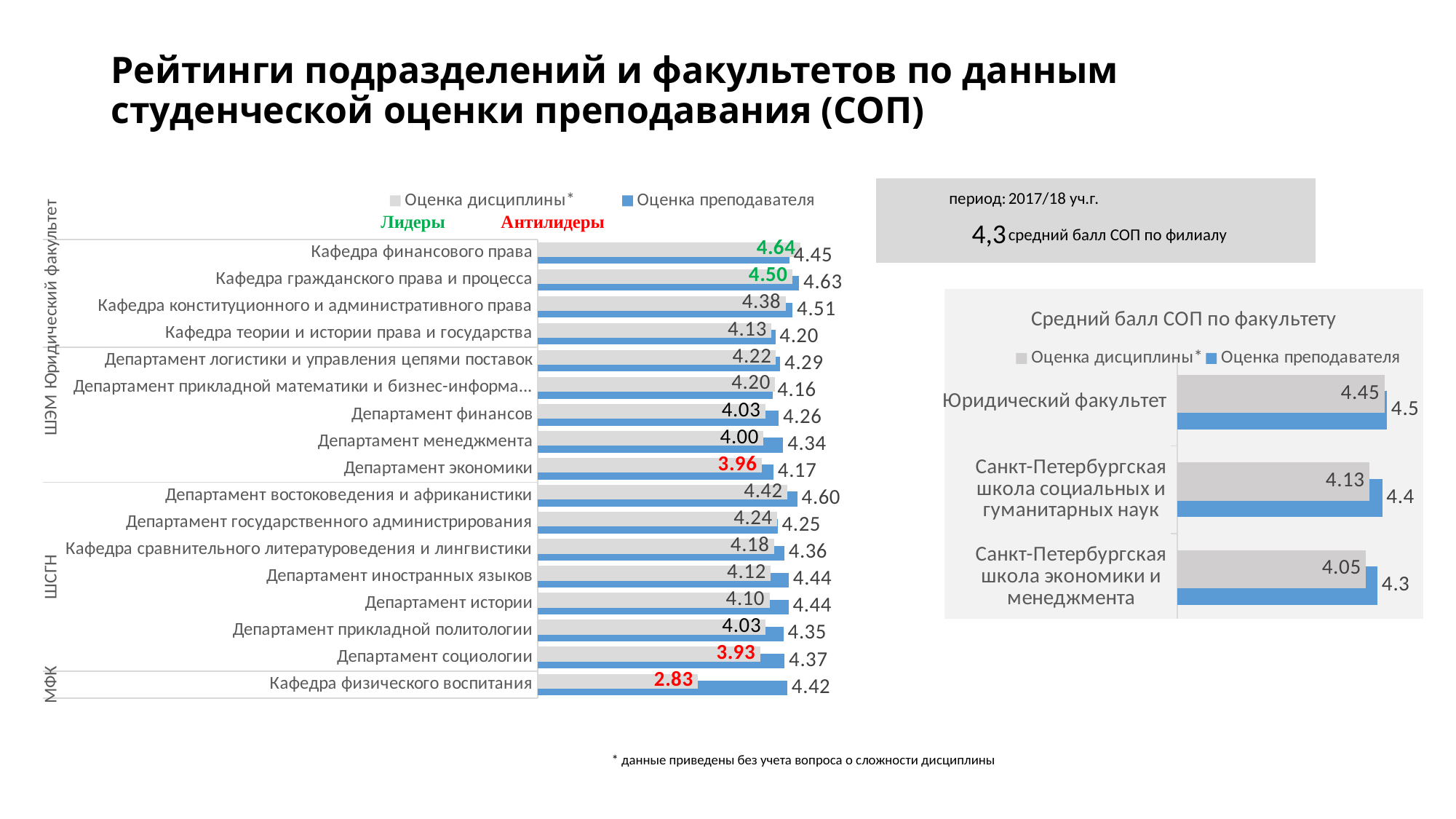
In the left chart, what is the difference between the Оценка преподавателя and Оценка дисциплины values for Кафедра физического воспитания? 1.59 In the left chart, what is the Оценка дисциплины value for Кафедра физического воспитания? 2.83 What kind of chart is the chart titled 'Средний балл СОП по факультету'? Bar chart In the left chart, which category has the lowest Оценка дисциплины value? Кафедра физического воспитания In the chart 'Средний балл СОП по факультету', what is the difference between the Оценка дисциплины values for Юридический факультет and Санкт-Петербургская школа экономики и менеджмента? 0.40 How many series does the legend of the left chart list? 2 In the left chart, which is larger for Департамент прикладной математики и бизнес-информатики: Оценка дисциплины or Оценка преподавателя? Оценка дисциплины In the chart 'Средний балл СОП по факультету', what is the Оценка преподавателя value for Санкт-Петербургская школа социальных и гуманитарных наук? 4.4 In the chart 'Средний балл СОП по факультету', which faculty has the lowest Оценка дисциплины value? Санкт-Петербургская школа экономики и менеджмента How many categories are plotted in the left chart? 17 In the left chart, which category has the highest Оценка дисциплины value? Кафедра финансового права In the left chart, what is the Оценка преподавателя value for Кафедра гражданского права и процесса? 4.63